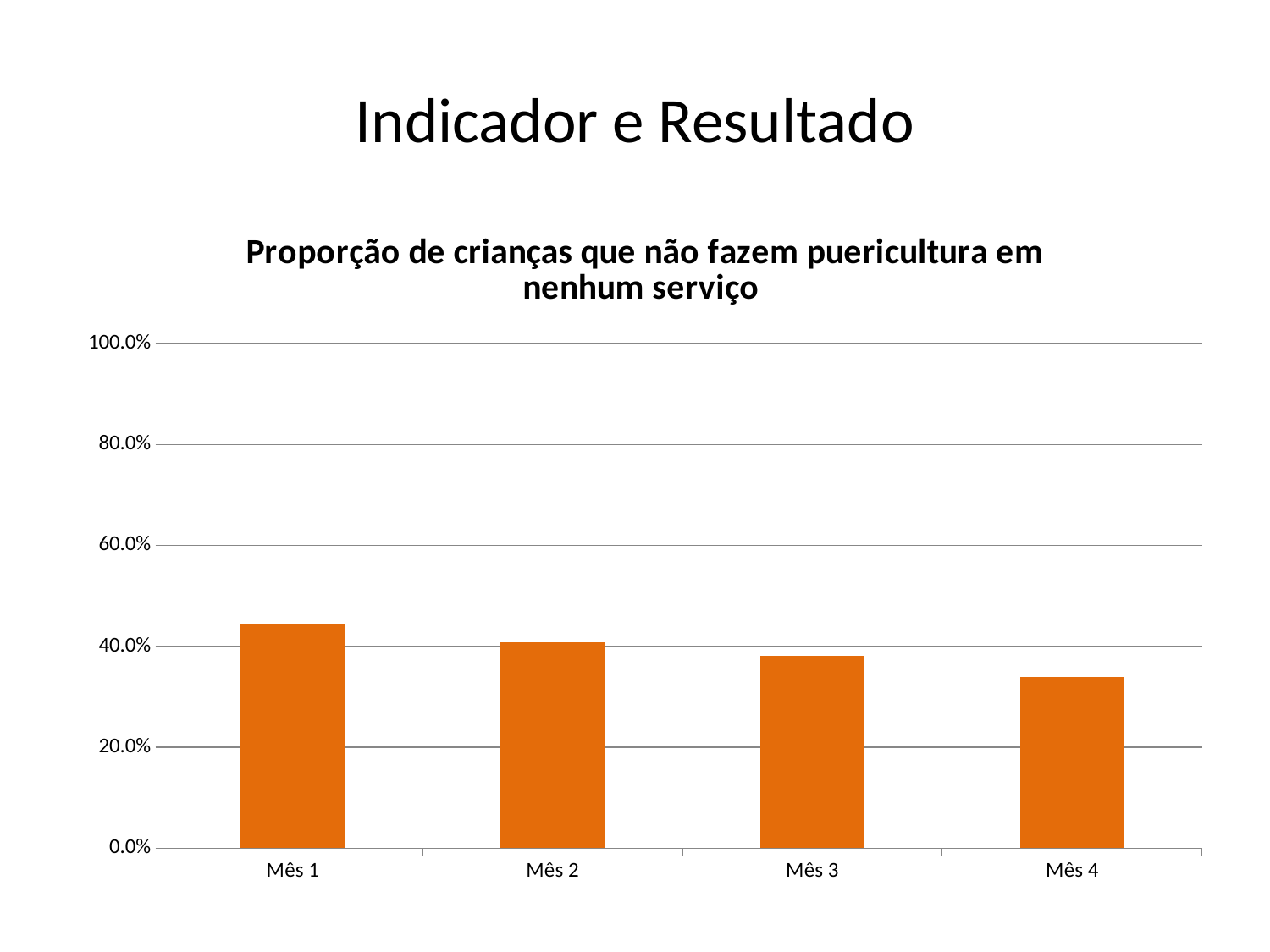
Is the value for Mês 1 greater or less than 60.0%? less Do the values rise or fall from Mês 1 to Mês 4? fall Is the value for Mês 1 greater or less than 40.0%? greater What kind of chart is shown on the slide? bar chart Which month has the lowest value? Mês 4 Is the value for Mês 4 greater or less than 40.0%? less Which is larger, the value for Mês 2 or the value for Mês 3? Mês 2 Which is larger, the value for Mês 1 or the value for Mês 4? Mês 1 How many categories (months) are plotted on the chart? 4 Which month has the highest value? Mês 1 What is the title of the chart? Proporção de crianças que não fazem puericultura em nenhum serviço